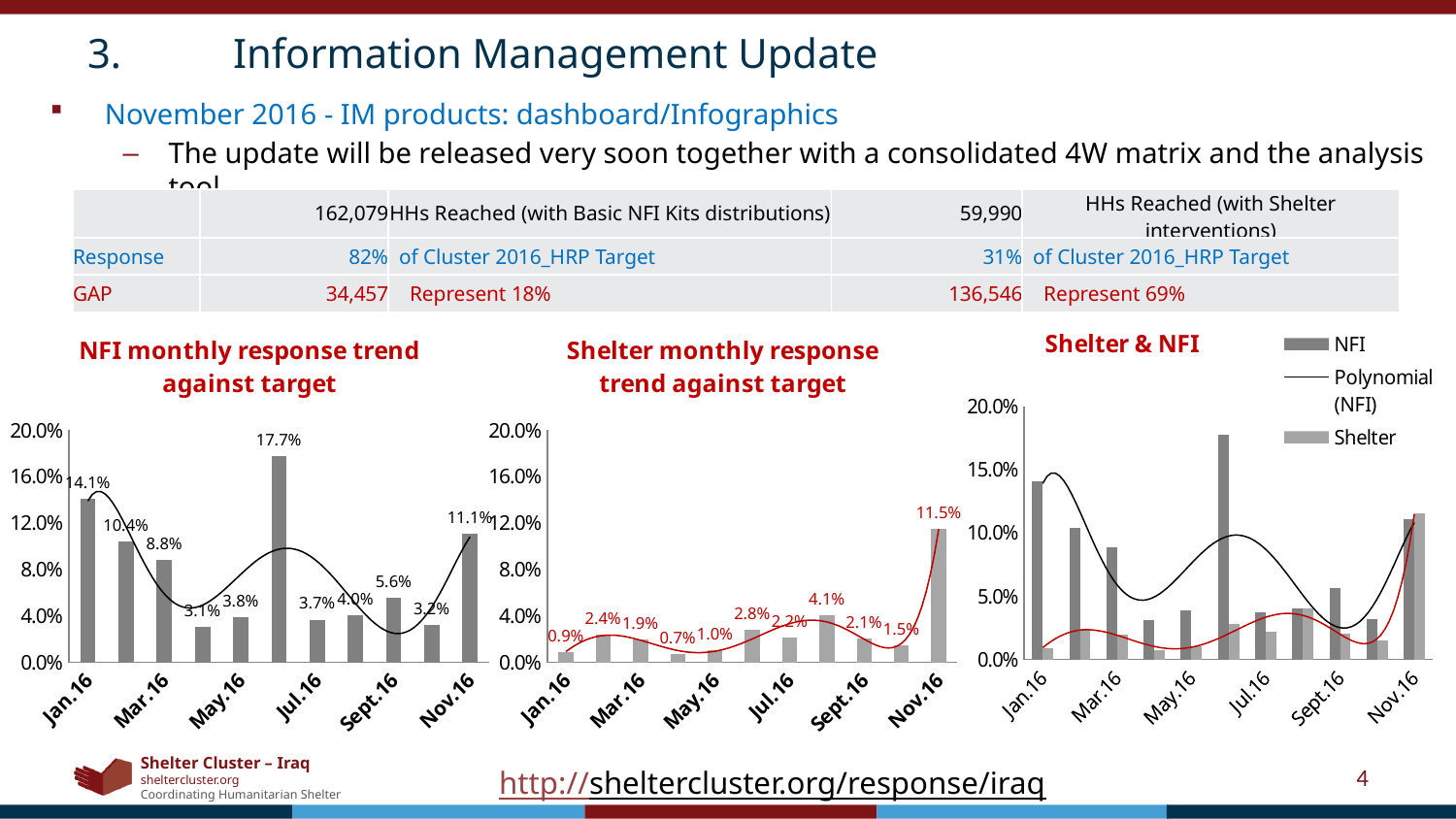
In the 'NFI monthly response trend against target' chart, what is the highest value shown? 17.7% In the 'Shelter & NFI' chart, is the NFI value for Jan.16 greater or less than 10.0%? greater In the 'Shelter monthly response trend against target' chart, which is larger, the value for Jul.16 or the value for Sept.16? Jul.16 In the 'NFI monthly response trend against target' chart, what is the lowest value shown? 3.1% In the 'Shelter monthly response trend against target' chart, what is the value for Jan.16? 0.9% In the 'Shelter monthly response trend against target' chart, what is the value for Nov.16? 11.5% What kind of chart is the 'Shelter monthly response trend against target' chart? Bar chart with a trend line How many series does the legend of the 'Shelter & NFI' chart list? 3 In the 'NFI monthly response trend against target' chart, what is the difference between the values for Jan.16 and Mar.16? 5.3% In the 'NFI monthly response trend against target' chart, what is the value for Nov.16? 11.1% In the 'NFI monthly response trend against target' chart, what is the value for Jan.16? 14.1% In the 'Shelter monthly response trend against target' chart, what is the lowest value shown? 0.7%